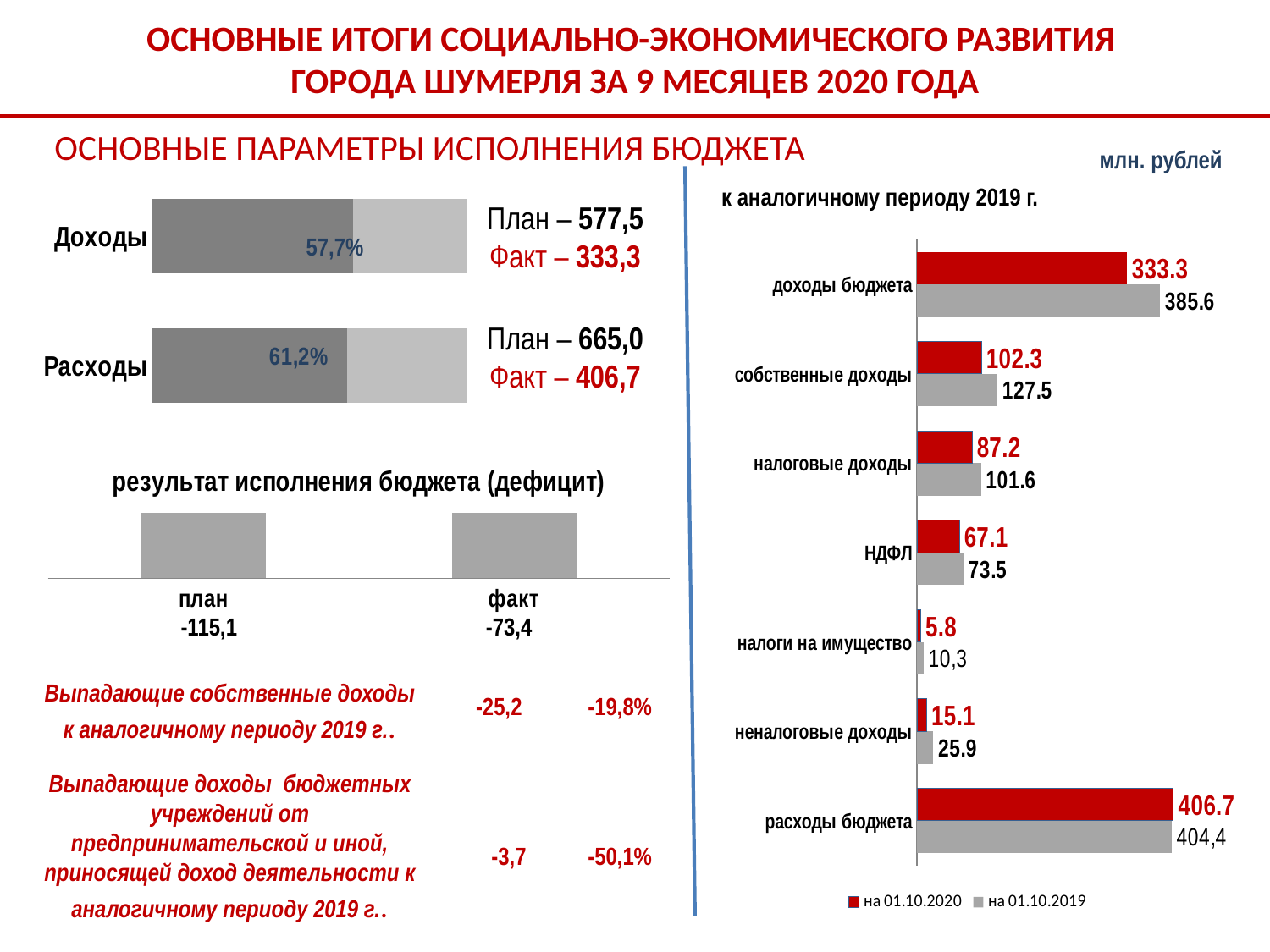
On the right-hand chart comparing to the same period of 2019, what is the value for доходы бюджета on 01.10.2020? 333.3 What kind of chart is the right-hand chart comparing to the same period of 2019? bar chart On the chart titled 'результат исполнения бюджета (дефицит)', what is the value for факт? -73,4 On the top-left chart of budget execution, what percentage is shown for Расходы? 61,2% On the right-hand chart comparing to the same period of 2019, what is the value for НДФЛ on 01.10.2020? 67.1 On the right-hand chart comparing to the same period of 2019, which is larger for налоговые доходы: the value on 01.10.2020 or on 01.10.2019? на 01.10.2019 On the right-hand chart comparing to the same period of 2019, which category has the lowest value on 01.10.2020? налоги на имущество On the right-hand chart comparing to the same period of 2019, what is the difference between the 01.10.2019 and 01.10.2020 values for собственные доходы? 25.2 On the right-hand chart comparing to the same period of 2019, how many series does the legend list? 2 On the right-hand chart comparing to the same period of 2019, which category has the highest value on 01.10.2020? расходы бюджета On the right-hand chart comparing to the same period of 2019, what is the value for собственные доходы on 01.10.2019? 127.5 On the right-hand chart comparing to the same period of 2019, how many categories are shown? 7